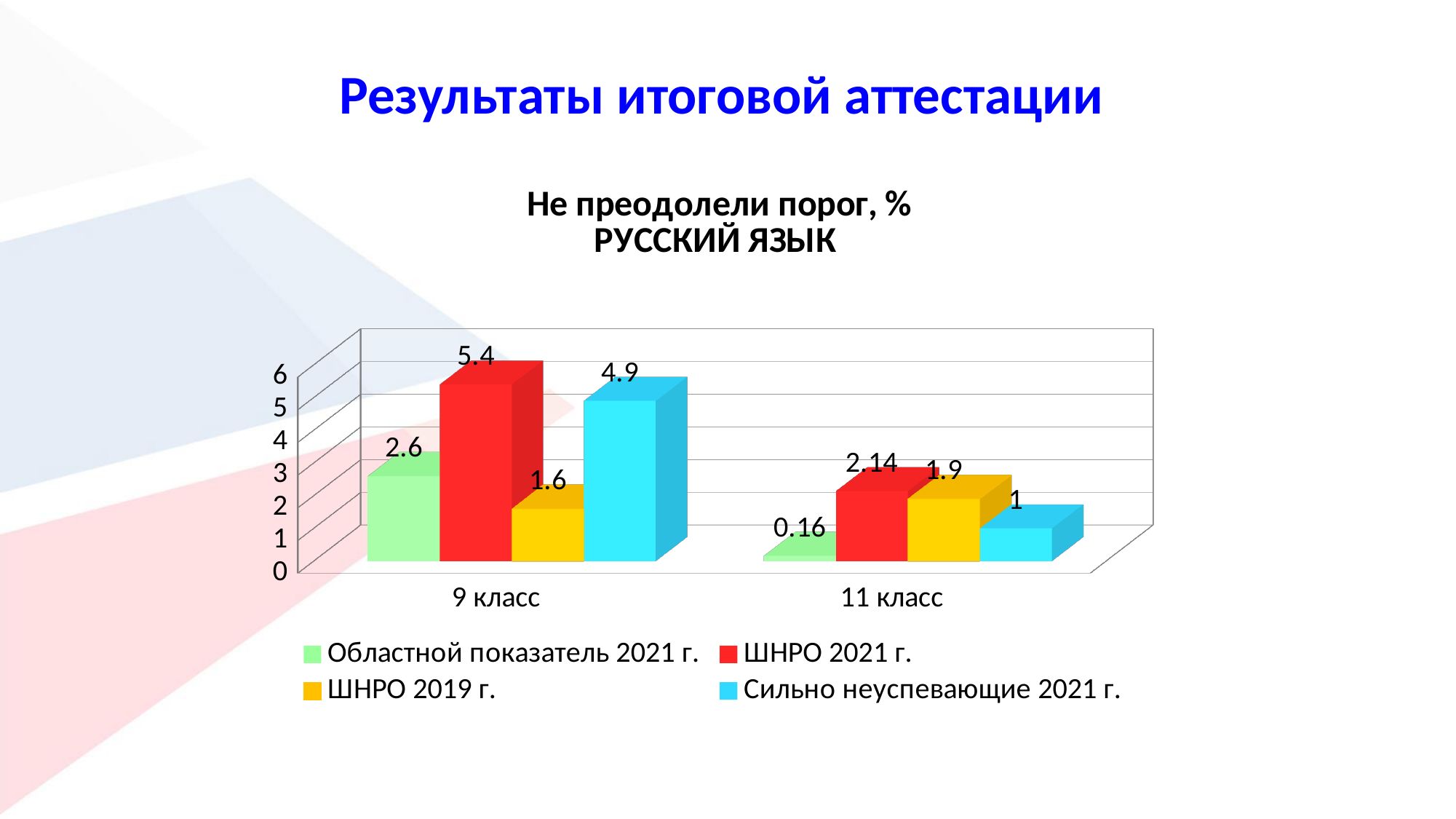
What is the value for Областной показатель 2021 г. in 11 класс? 0.16 Which is larger: ШНРО 2019 г. in 9 класс or ШНРО 2019 г. in 11 класс? 11 класс How many series does the legend list? 4 Which series has the highest value in 9 класс? ШНРО 2021 г. What type of chart is shown on the slide? bar chart What is the title of the chart? Не преодолели порог, % РУССКИЙ ЯЗЫК What is the value for ШНРО 2019 г. in 11 класс? 1.9 Which series has the lowest value in 11 класс? Областной показатель 2021 г. How many categories are shown on the x axis? 2 What is the difference between the ШНРО 2021 г. values for 9 класс and 11 класс? 3.26 What is the value for ШНРО 2021 г. in 9 класс? 5.4 What is the value for Сильно неуспевающие 2021 г. in 9 класс? 4.9